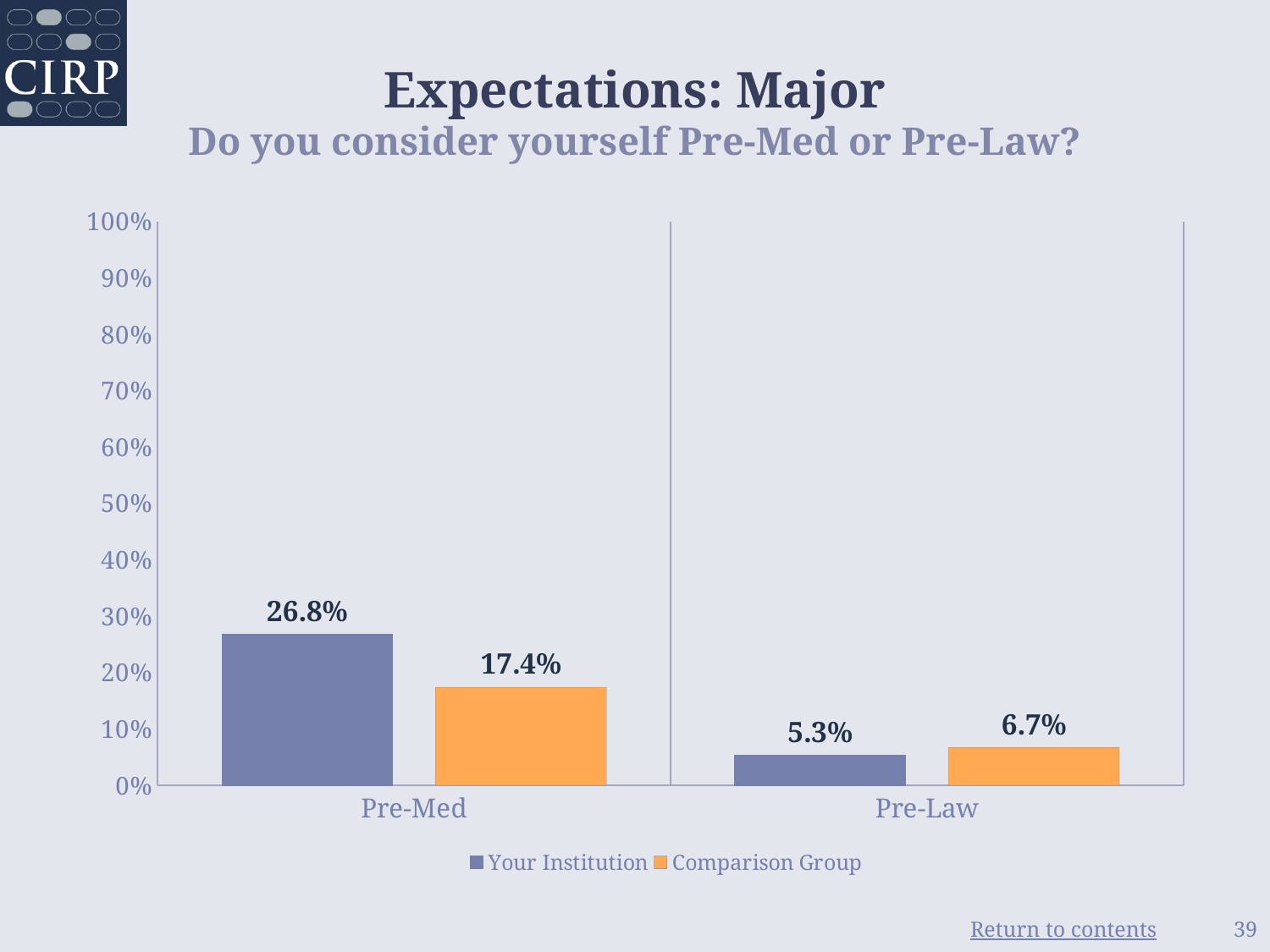
What kind of chart is shown on the slide? bar chart What is the subtitle question shown above the chart? Do you consider yourself Pre-Med or Pre-Law? Which category has the lowest value for Comparison Group? Pre-Law How many categories are shown on the x axis? 2 How many series does the legend list? 2 What is the value for Your Institution in the Pre-Med category? 26.8% What is the difference between Your Institution and Comparison Group in the Pre-Med category? 9.4% What is the value for Your Institution in the Pre-Law category? 5.3% In the Pre-Law category, which is larger: Your Institution or Comparison Group? Comparison Group What is the value for Comparison Group in the Pre-Law category? 6.7% Is the value for Comparison Group in the Pre-Med category greater or less than 20%? less Which category has the highest value for Your Institution? Pre-Med